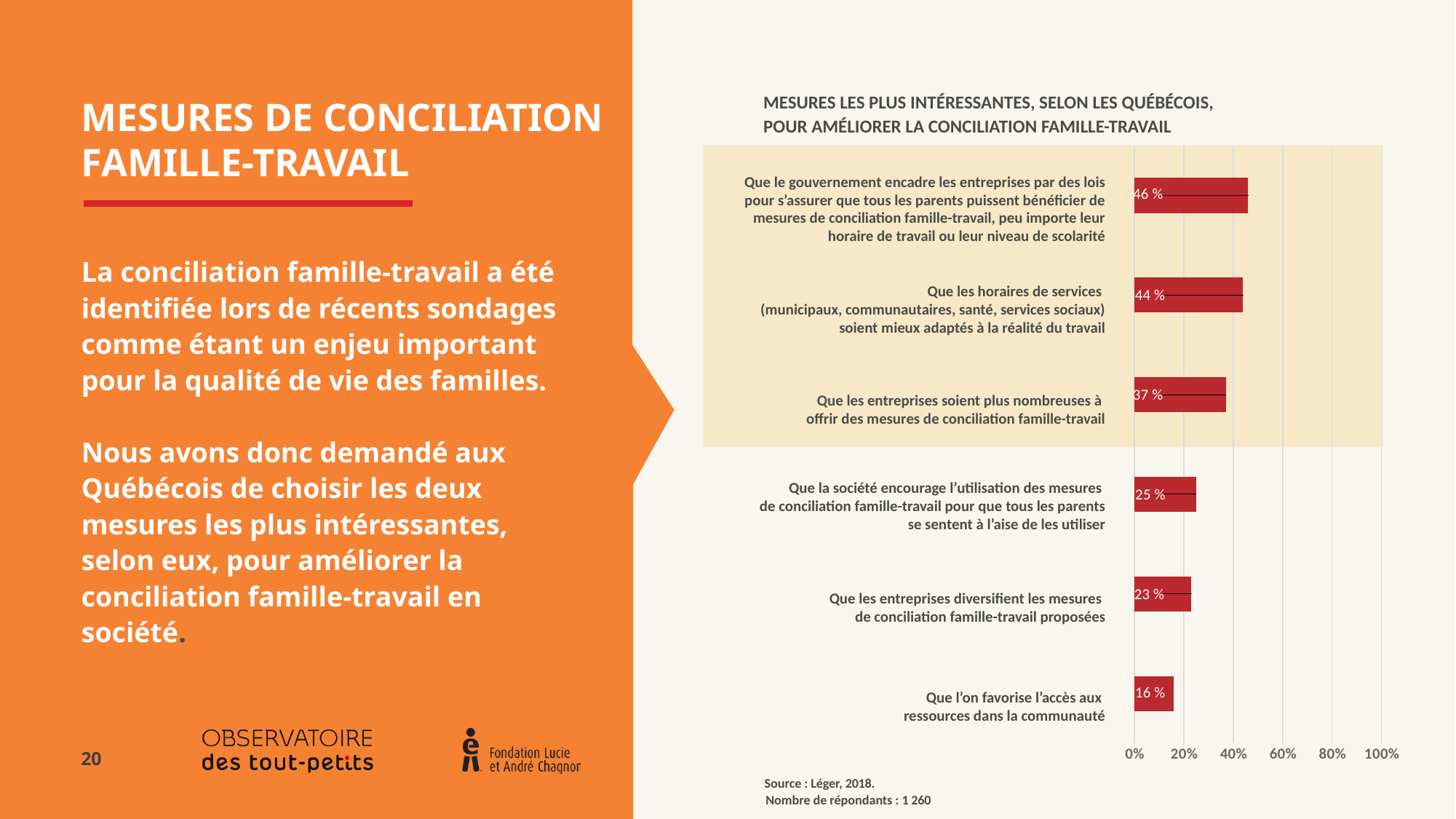
What type of chart is shown on the slide? Bar chart What percentage is shown for the measure that companies diversify the family-work balance measures offered? 23 % What percentage is shown for the measure that more companies offer family-work balance measures? 37 % What is the difference in percentage points between the highest measure (46 %) and the lowest measure (16 %)? 30 What percentage of Québécois chose the measure that the government regulate companies by law so all parents can benefit from family-work balance measures? 46 % Which measure has the lowest percentage in the chart? Que l'on favorise l'accès aux ressources dans la communauté What value is shown for the measure that service hours (municipal, community, health, social services) be better adapted to work realities? 44 % How many measures (bars) are shown in the chart? 6 Which measure has the highest percentage in the chart? Que le gouvernement encadre les entreprises par des lois pour s'assurer que tous les parents puissent bénéficier de mesures de conciliation famille-travail What is the number of respondents indicated below the chart? 1 260 Which is larger: the value for more companies offering family-work balance measures, or the value for society encouraging the use of such measures? More companies offering family-work balance measures (37 %) What value is shown for the measure that society encourage the use of family-work balance measures so all parents feel comfortable using them? 25 %